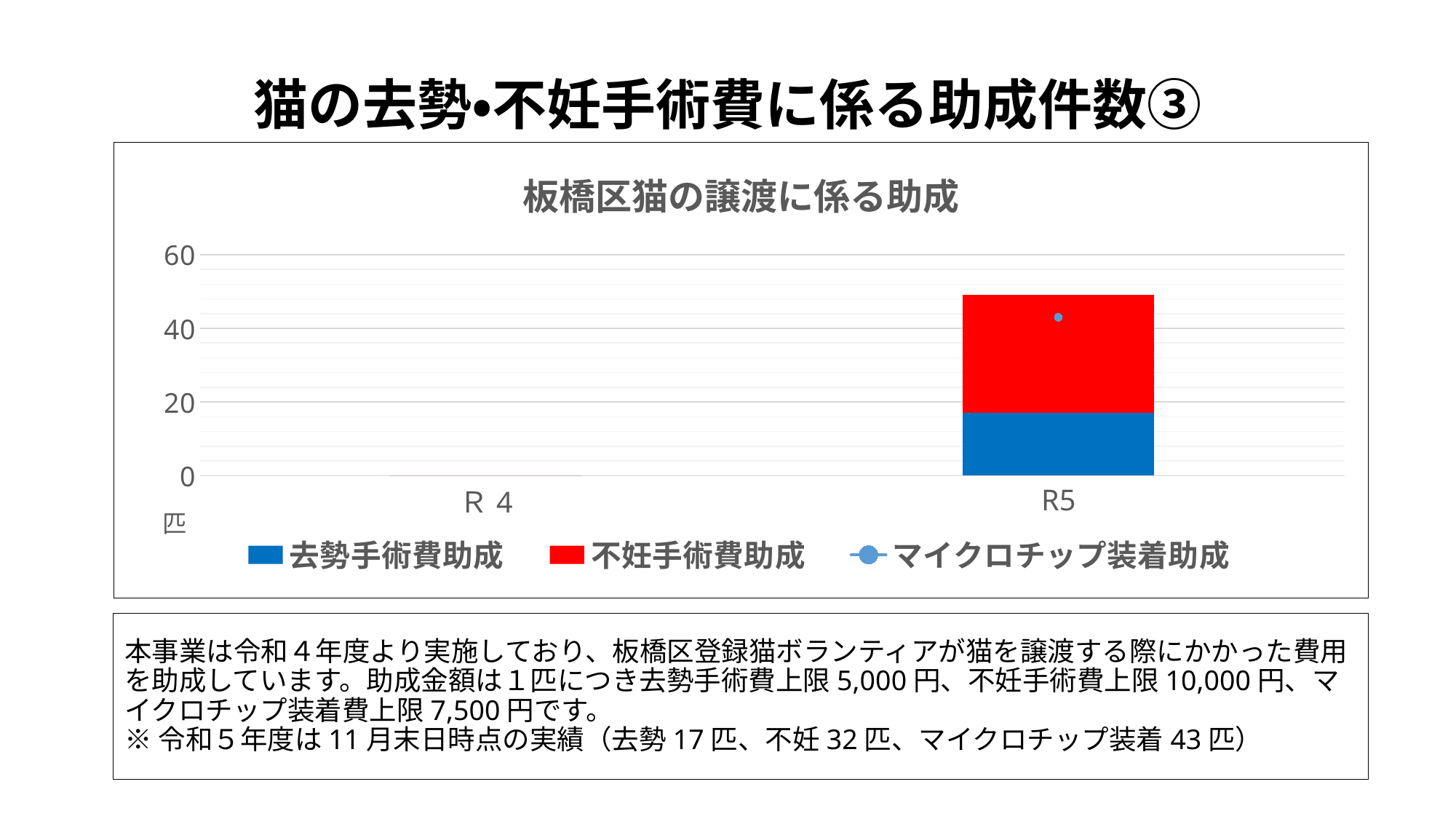
Is the value for 去勢手術費助成 in R5 greater or less than 20? less In R5, which is larger, 去勢手術費助成 or 不妊手術費助成? 不妊手術費助成 How many categories are shown on the x axis? 2 How many series does the legend list? 3 Is the total height of the stacked bar for R5 greater or less than 40? greater What is the title of the chart? 板橋区猫の譲渡に係る助成 What kind of chart is shown on the slide? combination bar and line chart (stacked bars with a line series) Which category has the highest stacked bar total, R4 or R5? R5 Do the stacked bar totals rise or fall from R4 to R5? rise Is the value for マイクロチップ装着助成 in R5 greater or less than 20? greater What colour represents 去勢手術費助成 in the chart? blue